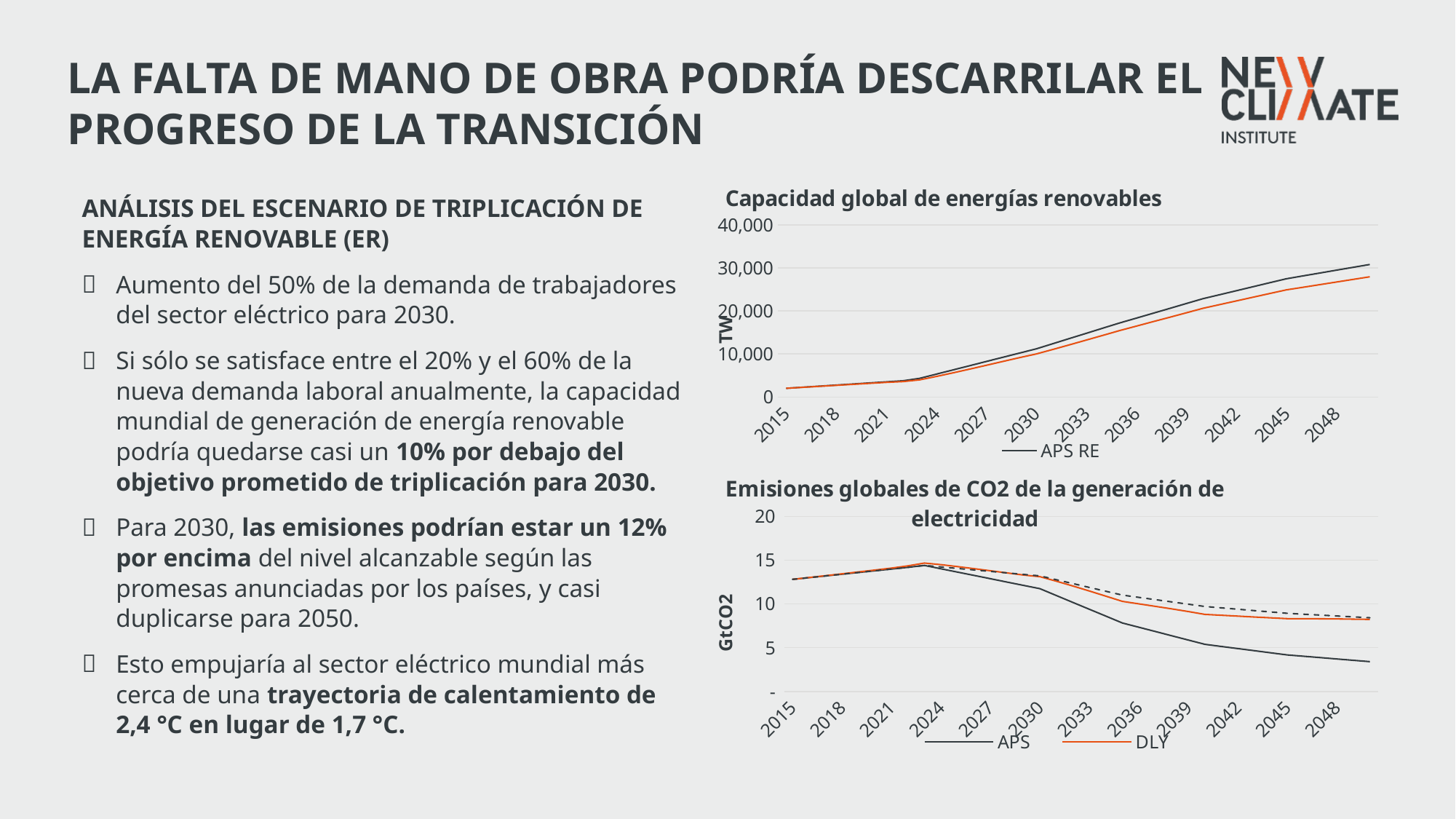
In the 'Emisiones globales de CO2 de la generación de electricidad' chart, is the DLY value for 2048 greater or less than 5? greater What kind of chart is 'Capacidad global de energías renovables'? line chart How many year labels are shown on the x axis of the 'Emisiones globales de CO2 de la generación de electricidad' chart? 12 In the 'Emisiones globales de CO2 de la generación de electricidad' chart, is the APS value for 2024 greater or less than 10? greater What kind of chart is 'Emisiones globales de CO2 de la generación de electricidad'? line chart What unit is shown on the y axis of the 'Emisiones globales de CO2 de la generación de electricidad' chart? GtCO2 In the 'Emisiones globales de CO2 de la generación de electricidad' chart, is the APS value for 2048 greater or less than 5? less In the 'Emisiones globales de CO2 de la generación de electricidad' chart, which series is higher in 2048, APS or DLY? DLY In the 'Emisiones globales de CO2 de la generación de electricidad' chart, does the APS series rise or fall from 2024 to 2048? fall In the 'Capacidad global de energías renovables' chart, do the values rise or fall from 2015 to 2048? rise